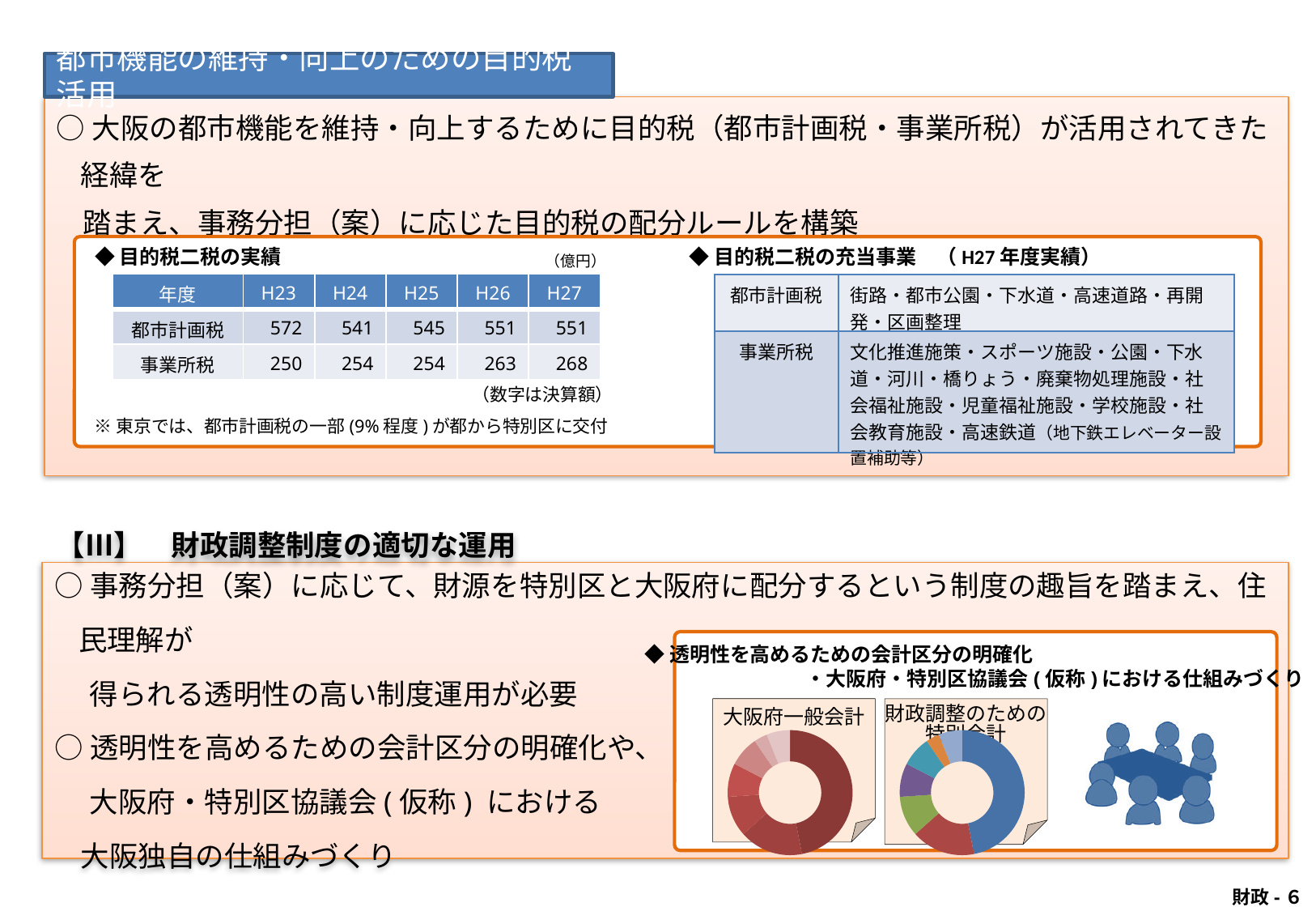
In the chart titled 財政調整のための特別会計, what colour is the largest slice? blue What is the title of the left-hand donut chart on the slide? 大阪府一般会計 What kind of chart is the chart titled 財政調整のための特別会計? pie chart (donut) What kind of chart is the chart titled 大阪府一般会計? pie chart (donut) How many charts are shown on the slide? 2 In the chart titled 大阪府一般会計, what colour is the largest slice? dark red